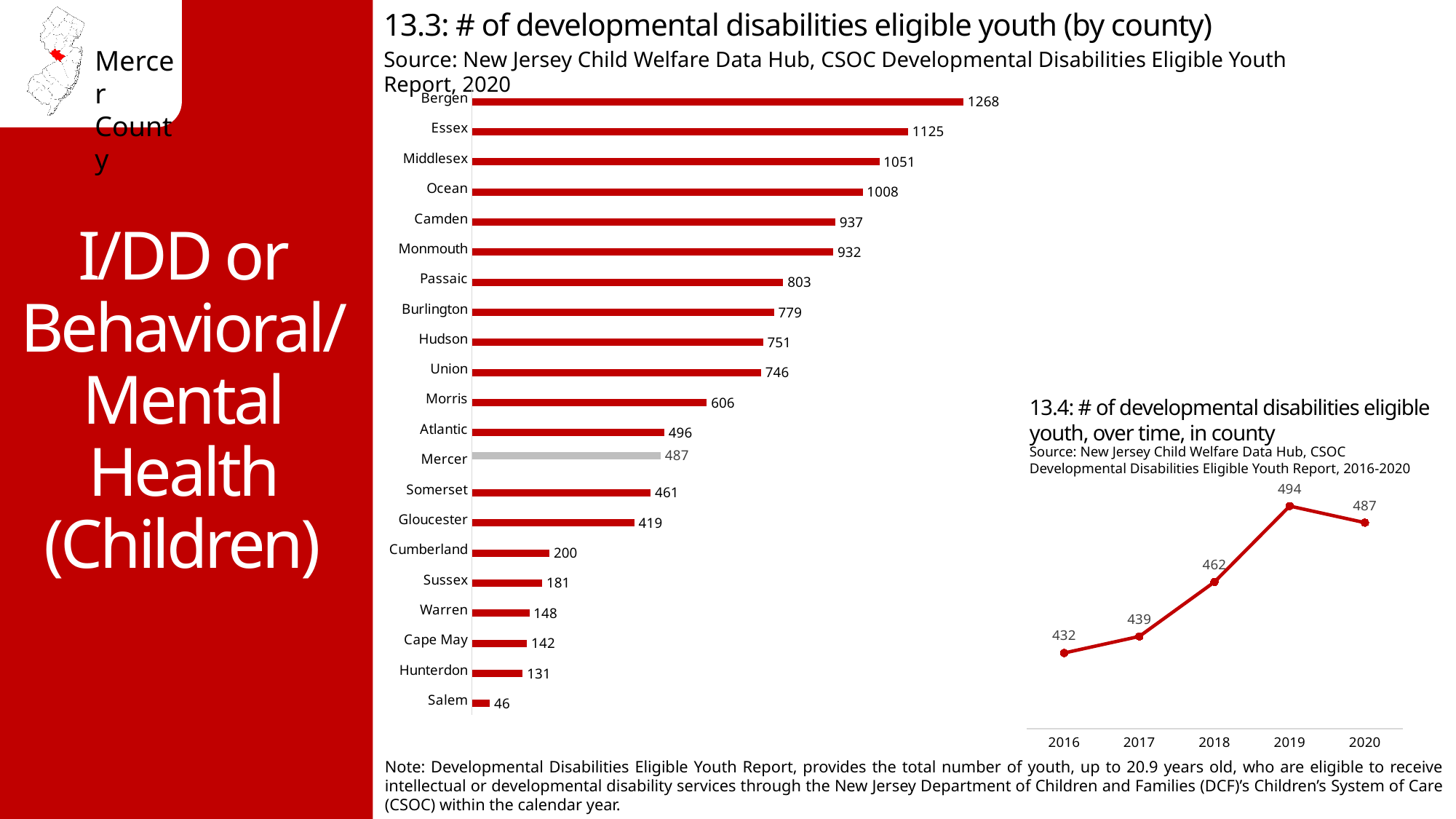
In chart 13.3 (by county), what is the difference between Bergen and Essex? 143 In chart 13.4 (over time, in county), how many years are plotted? 5 In chart 13.3 (by county), how many counties are shown? 21 In chart 13.3 (by county), which is larger, Camden or Monmouth? Camden In chart 13.3 (by county), what is the value for Ocean? 1008 In chart 13.3 (# of developmental disabilities eligible youth by county), what is the value for Mercer? 487 What type of chart is chart 13.3 (by county)? Bar chart In chart 13.3 (by county), which bar is shown in a different colour (grey) from the others? Mercer In chart 13.4 (over time, in county), what is the value for 2019? 494 In chart 13.3 (by county), which county has the highest number of developmental disabilities eligible youth? Bergen In chart 13.4 (over time, in county), what is the difference between 2019 and 2020? 7 In chart 13.3 (by county), which county has the lowest number of developmental disabilities eligible youth? Salem